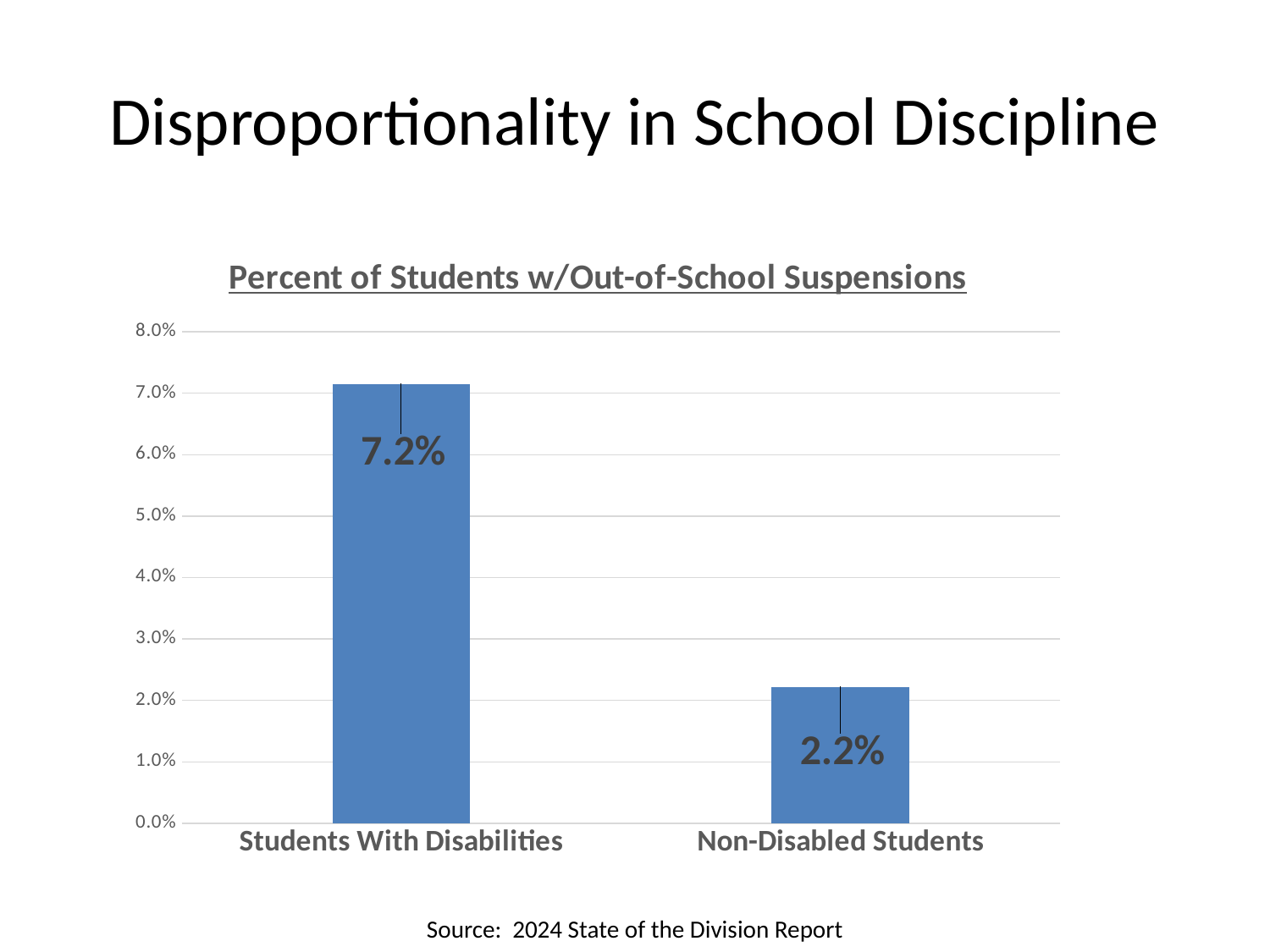
Which category has the highest percent of students with out-of-school suspensions? Students With Disabilities What is the percent of students with out-of-school suspensions for Students With Disabilities? 7.2% Is the value for Students With Disabilities greater or less than 5.0%? greater Which is larger: the value for Students With Disabilities or the value for Non-Disabled Students? Students With Disabilities Is the value for Non-Disabled Students greater or less than 3.0%? less What is the percent of students with out-of-school suspensions for Non-Disabled Students? 2.2% What is the title of the chart? Percent of Students w/Out-of-School Suspensions How many categories are shown in the chart? 2 What kind of chart is shown on the slide? Bar chart What is the maximum value shown on the y axis? 8.0% What is the difference in percentage points between Students With Disabilities and Non-Disabled Students? 5.0% Which category has the lowest percent of students with out-of-school suspensions? Non-Disabled Students